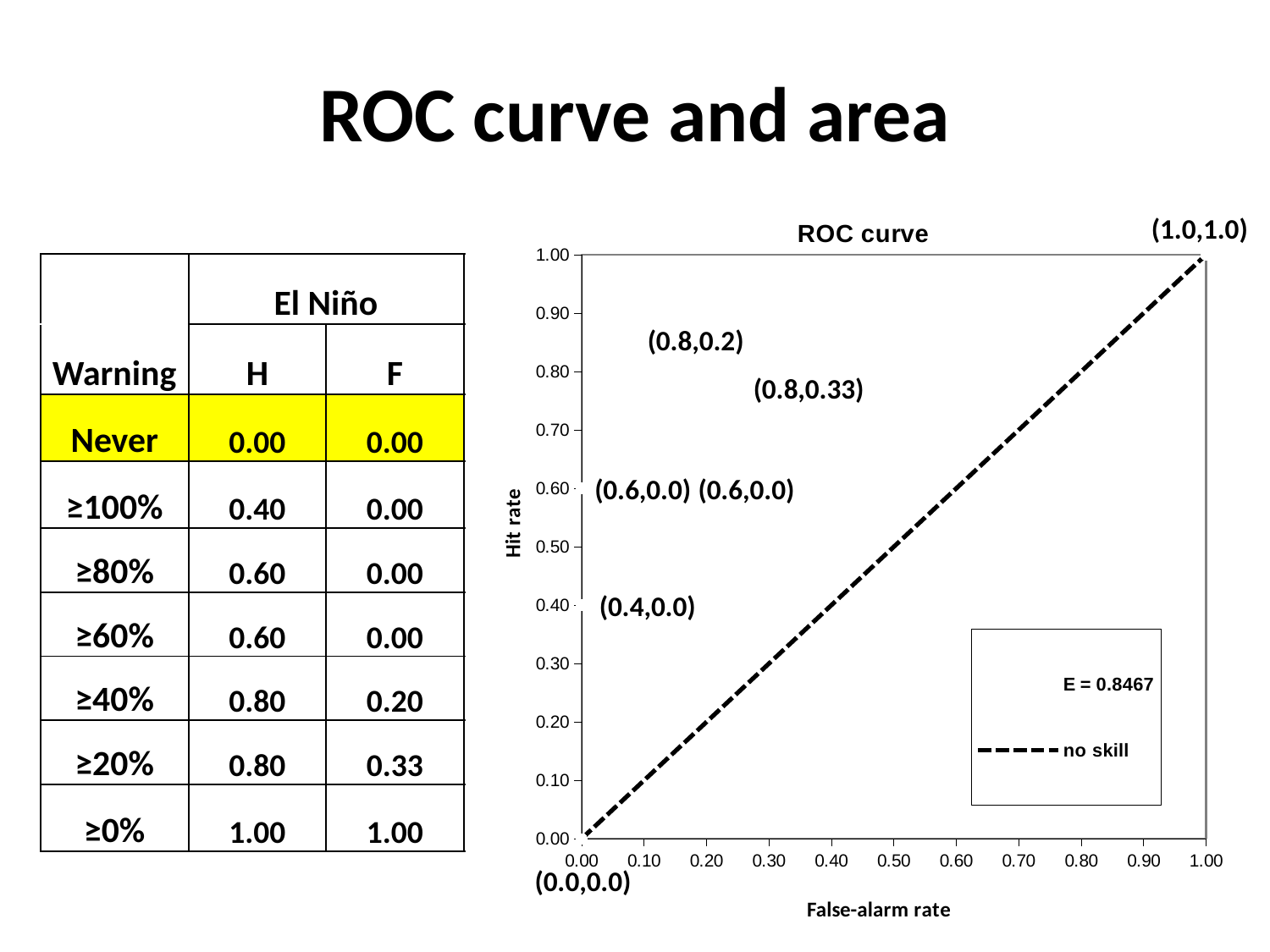
What is the highest value shown on the y axis of the ROC curve chart? 1.00 How many entries does the legend of the ROC curve chart list? 2 What kind of chart is the ROC curve chart? line chart Does the 'no skill' line in the ROC curve chart rise or fall as the false-alarm rate increases? rise What is the label of the x axis of the ROC curve chart? False-alarm rate How many coordinate labels are written on the ROC curve chart? 7 What coordinate label is written at the bottom-left corner of the ROC curve chart? (0.0,0.0) What value of E is shown in the legend of the ROC curve chart? E = 0.8467 What coordinate label is written at the top-right corner of the ROC curve chart? (1.0,1.0) What is the title of the chart on the slide? ROC curve In the ROC curve chart, what hit rate does the 'no skill' line reach at a false-alarm rate of 1.00? 1.00 In the ROC curve chart, what hit rate does the 'no skill' line have at a false-alarm rate of 0.00? 0.00